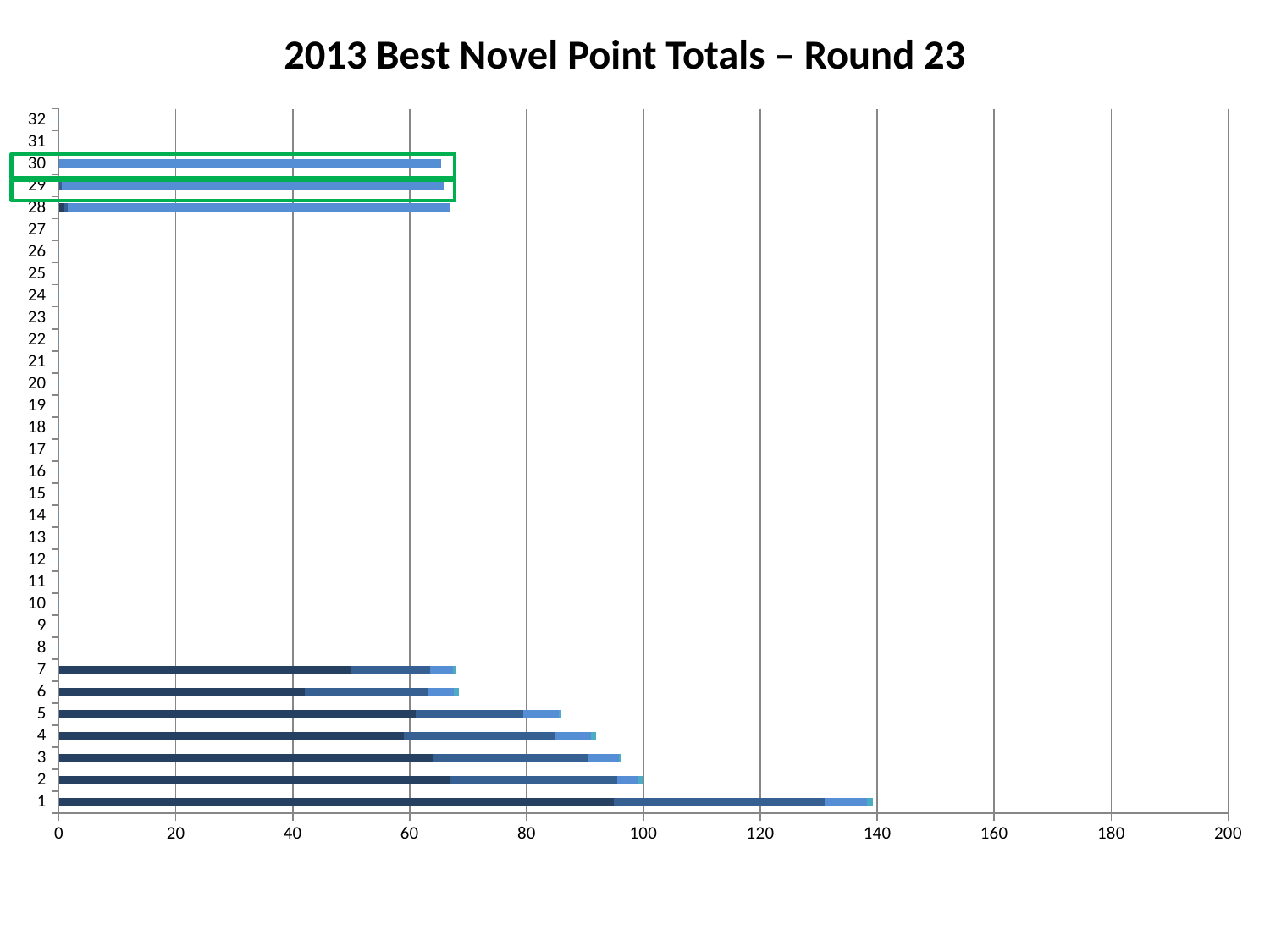
Which two categories are outlined with green boxes on the chart? 29 and 30 Is the total value for category 7 greater or less than 80? less What kind of chart is shown on the slide? bar chart How many categories have a visible bar plotted? 10 Is the total value for category 5 greater or less than 80? greater Is the total value for category 30 greater or less than 60? greater What is the title of the chart? 2013 Best Novel Point Totals – Round 23 Which has the larger total, category 1 or category 2? 1 Which category has the longest bar? 1 How many category labels are shown on the vertical axis? 32